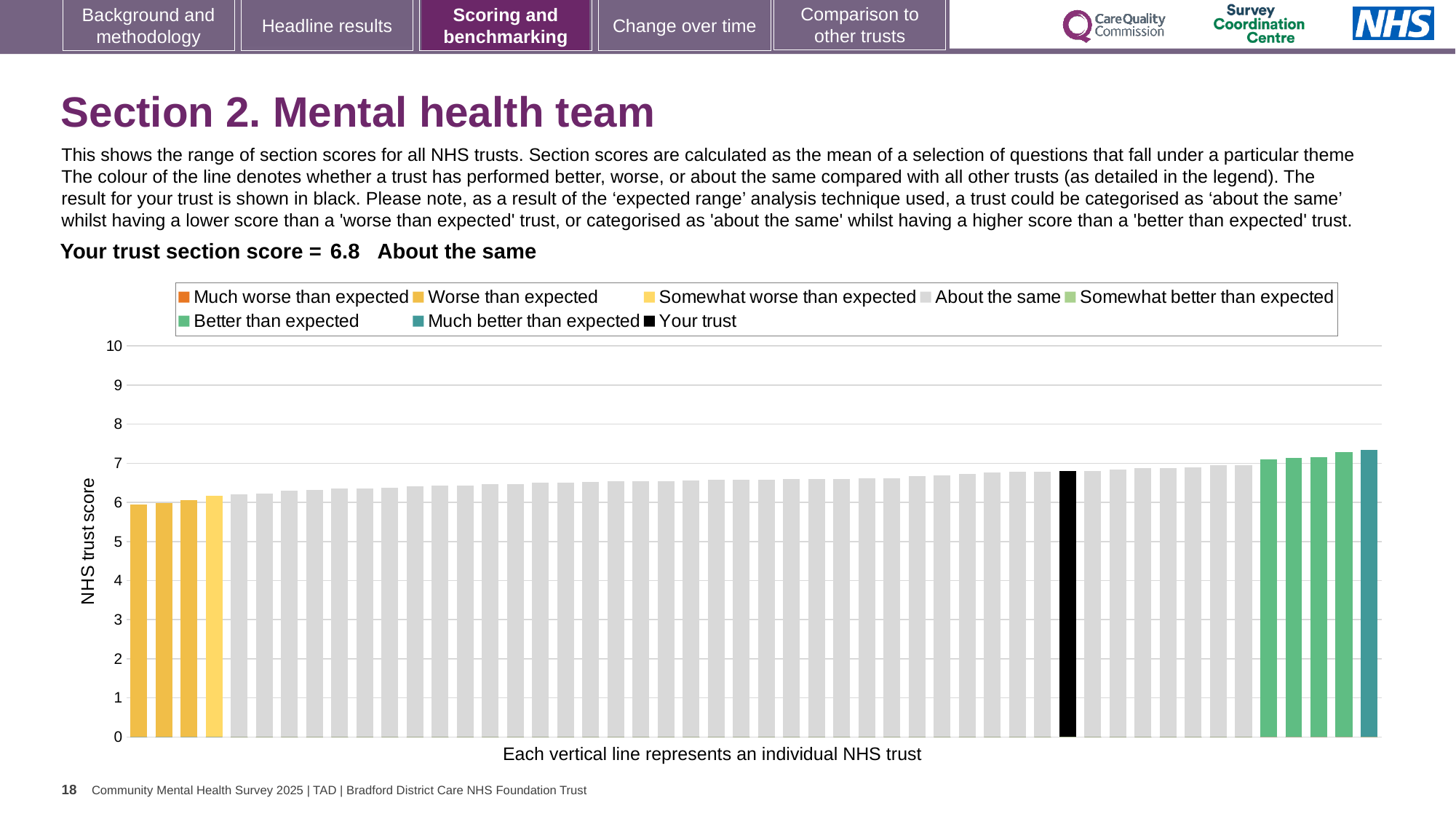
Which is taller: the black bar for your trust or the leftmost bar? The black bar for your trust What is the section score for your trust shown on the slide? 6.8 What colour is the bar representing your trust? Black Do the bar values rise or fall moving from left to right along the x axis? rise Is the value for your trust (the black bar) greater or less than 7? less Which benchmarking category is your trust placed in for this section? About the same How many entries does the chart legend list? 8 Is the shortest bar on the chart greater or less than 5? greater Is the value for your trust (the black bar) greater or less than 6? greater What is the label on the vertical axis of the chart? NHS trust score What kind of chart is shown on the slide? Bar chart